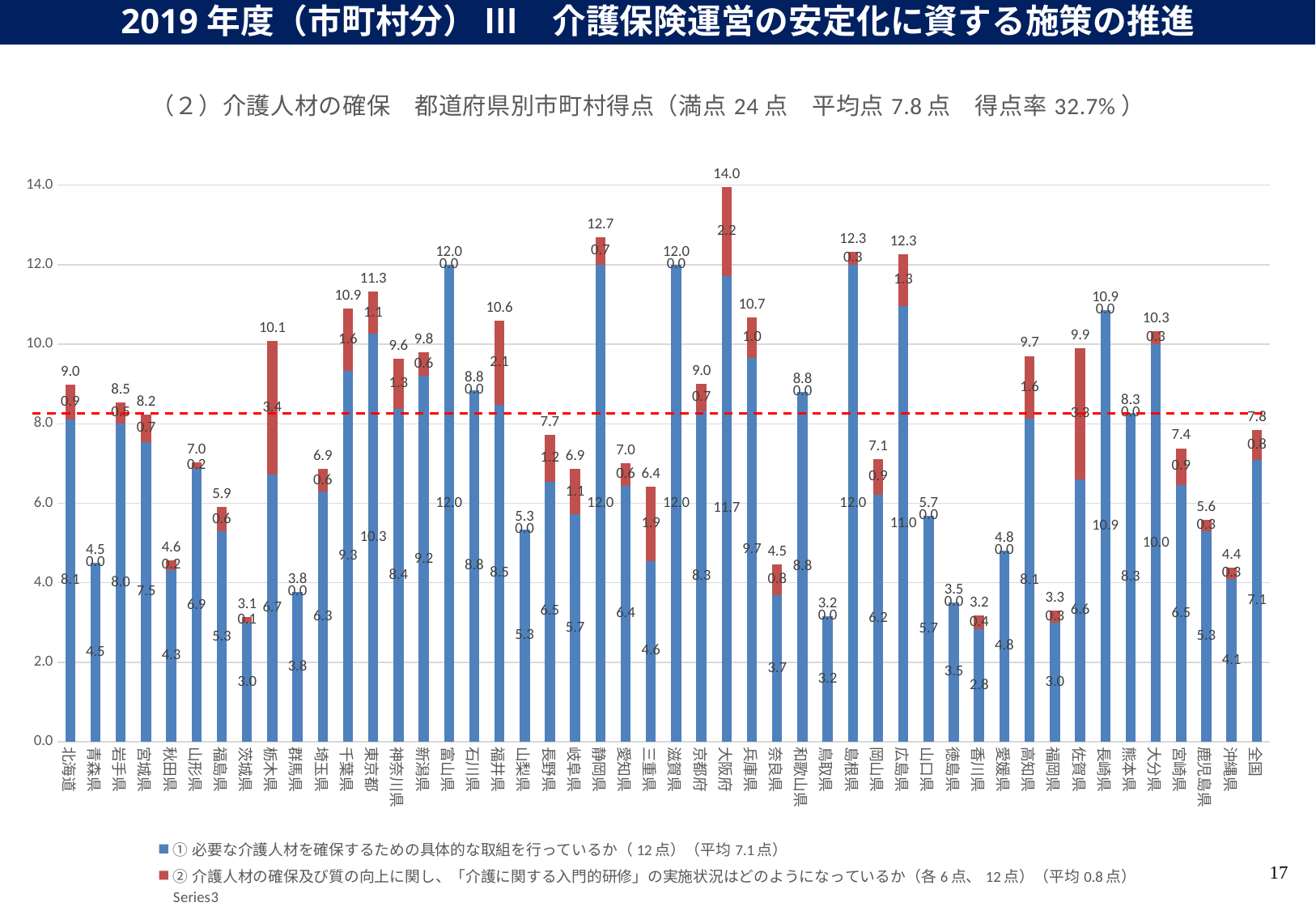
Which prefecture has the highest total score? 大阪府 What is the value of series ① (blue segment) for 東京都? 10.3 How many series does the legend list? 3 What is the total score for 大阪府? 14.0 Which has a higher total score, 千葉県 or 神奈川県? 千葉県 What is the difference between the total scores of 静岡県 and 愛知県? 5.7 Is the total score for 鳥取県 greater or less than 4.0? less What is the value of series ② (red segment) for 栃木県? 3.4 Which prefecture has the lowest total score? 茨城県 What kind of chart is shown on the slide? Stacked bar chart What is the total of the stacked bar for 佐賀県 (6.6 + 3.3)? 9.9 What is the total score for 全国? 7.8